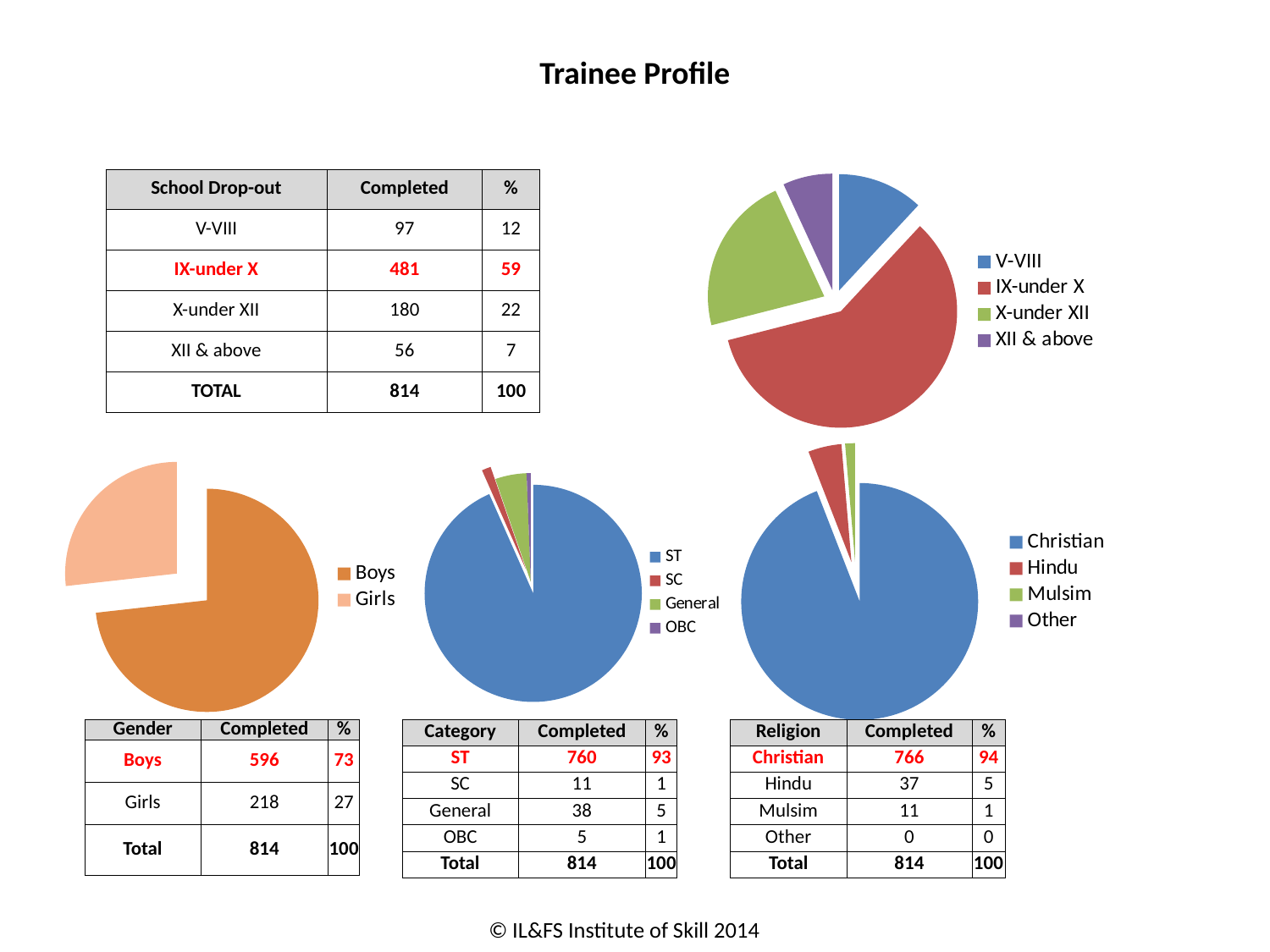
In the Gender pie chart at the bottom left, what is the difference between the Boys and Girls completed counts? 378 How many categories does the legend of the School Drop-out pie chart at the top right list? 4 In the Category pie chart at the bottom middle, which category has the smallest slice? OBC What type of chart is used for the Religion data at the bottom right of the slide? Pie chart In the Religion pie chart at the bottom right, what is the completed count for Christian? 766 In the Religion pie chart at the bottom right, which is larger, Hindu or Mulsim? Hindu In the Gender pie chart at the bottom left, what is the completed count for Girls? 218 In the School Drop-out pie chart at the top right, which category has the largest slice? IX-under X In the Category pie chart at the bottom middle, what is the completed count for General? 38 In the School Drop-out pie chart at the top right, what share of the total does XII & above represent? 7 In the School Drop-out pie chart at the top right, what is the completed count for X-under XII? 180 In the Gender pie chart at the bottom left, what percentage share do Boys have? 73